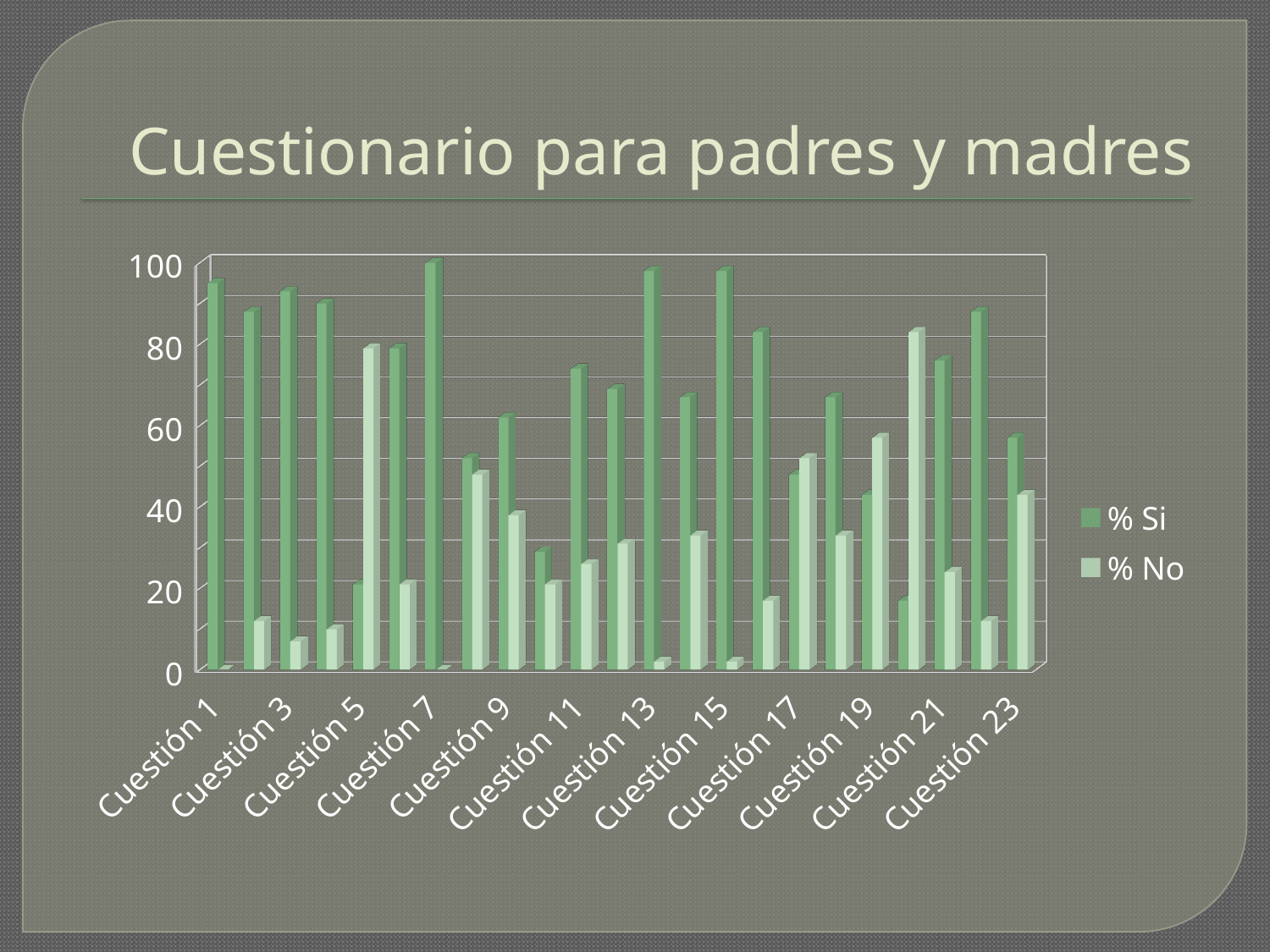
For Cuestión 1, which is larger, % Si or % No? % Si Is the % Si value for Cuestión 7 greater or less than 80? greater What kind of chart is shown on the slide? bar chart What is the title of the slide containing the chart? Cuestionario para padres y madres For Cuestión 5, which is larger, % Si or % No? % No Is the % No value for Cuestión 5 greater or less than 60? greater Is the % No value for Cuestión 13 greater or less than 20? less How many series does the legend list? 2 What are the two series named in the legend? % Si and % No